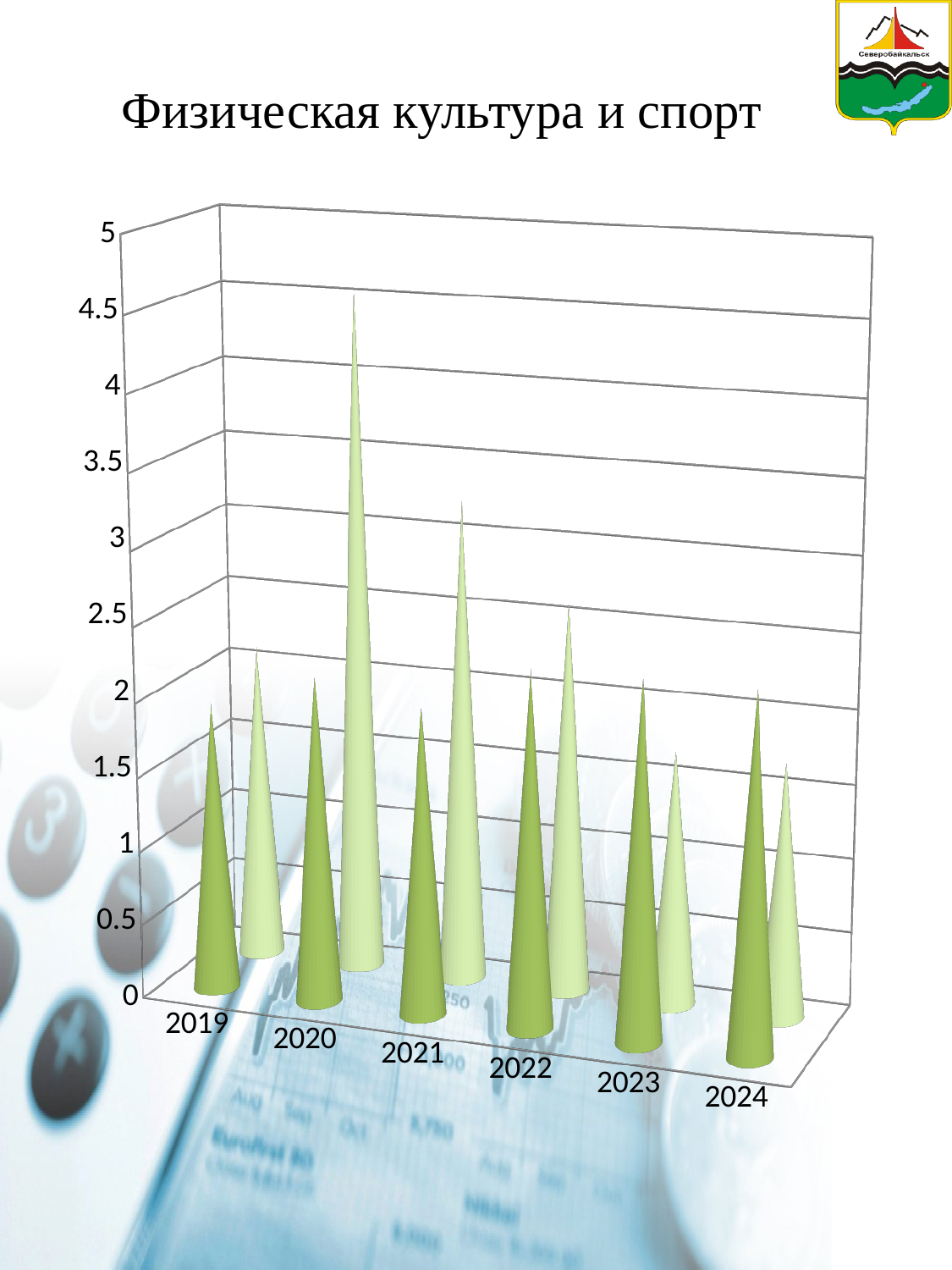
Is the value of the lighter green cone for 2021 greater or less than 2.5? greater Is the value of the lighter green cone for 2024 greater or less than 2.5? less What kind of chart is shown on the slide? bar chart Which year has the tallest cone on the chart? 2020 Which is larger, the lighter green cone for 2020 or the lighter green cone for 2021? 2020 What is the highest value shown on the vertical axis of the chart? 5 What is the title of the slide? Физическая культура и спорт Is the value of the darker green cone for 2019 greater or less than 2.5? less How many years are shown along the x axis of the chart? 6 How many cones are plotted for each year on the chart? 2 Do the lighter green cones rise or fall from 2021 to 2024? fall